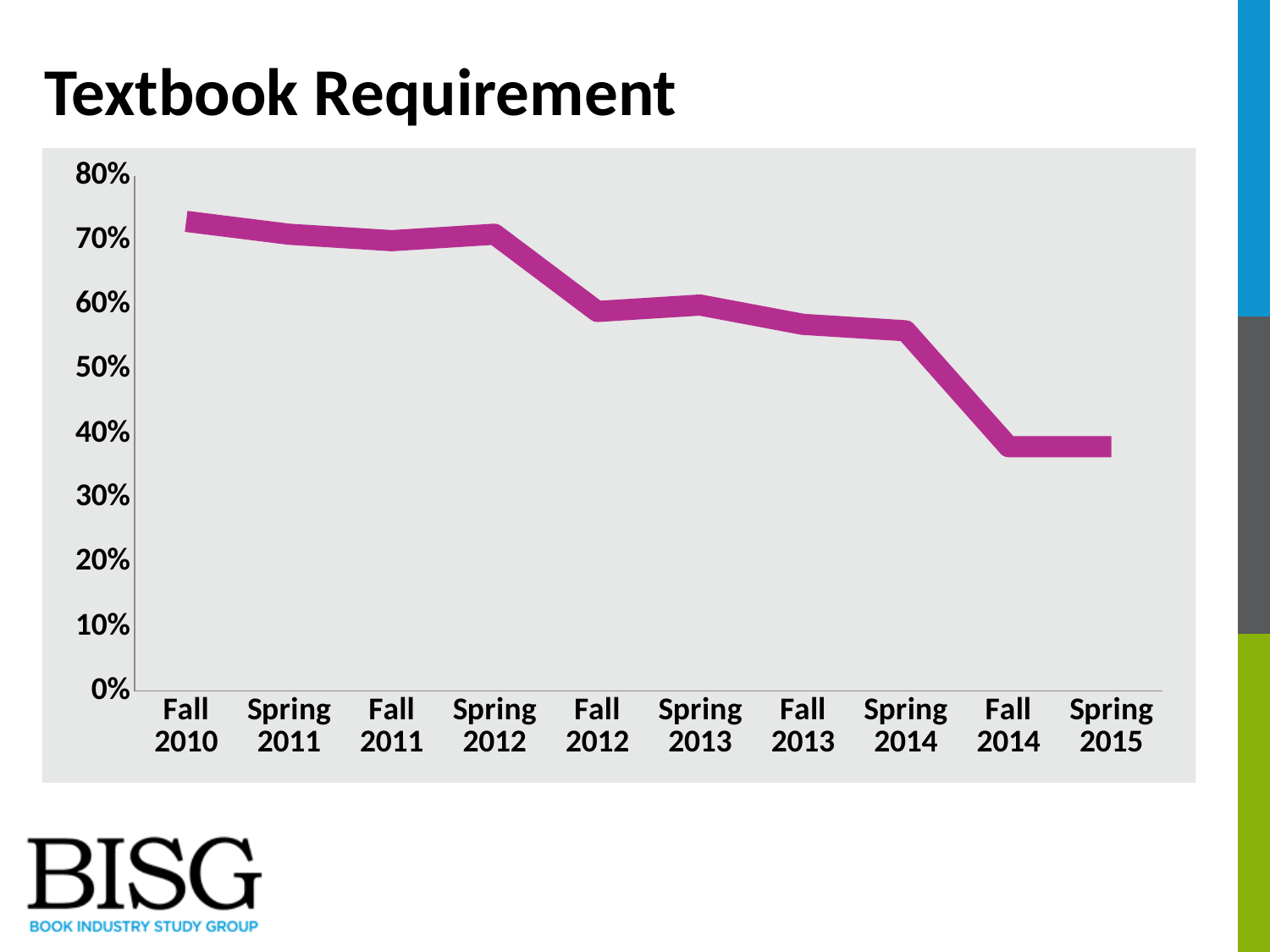
Which is larger, the value for Spring 2012 or the value for Fall 2012? Spring 2012 Do the values generally rise or fall from Fall 2010 to Spring 2015? fall What kind of chart is shown on the slide? line chart Is the value for Spring 2015 greater or less than 30%? greater Is the value for Fall 2014 greater or less than 40%? less What is the highest value shown on the vertical axis? 80% Is the value for Fall 2012 greater or less than 50%? greater How many data points are plotted on the line? 10 What is the title of the chart? Textbook Requirement Which is larger, the value for Fall 2010 or the value for Spring 2015? Fall 2010